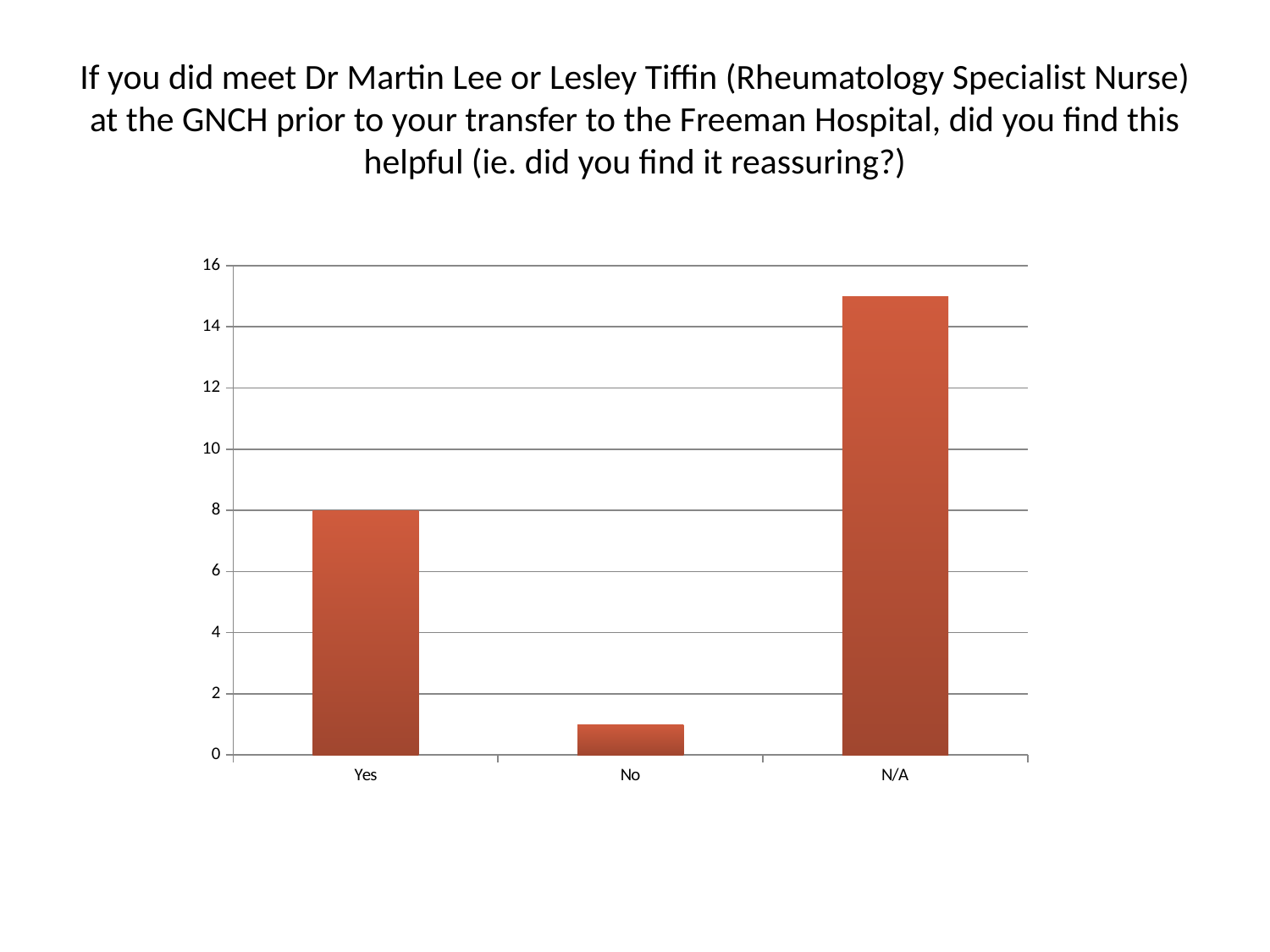
Is the value for Yes greater or less than 10? less What is the highest value shown on the y axis of the chart? 16 Which is larger, the value for Yes or the value for No? Yes Is the value for No greater or less than 2? less What is the value for the Yes category? 8 What are the three category labels on the x axis, from left to right? Yes, No, N/A Which category has the lowest value? No Which is larger, the value for Yes or the value for N/A? N/A Which category has the highest value? N/A How many categories are shown on the x axis of the chart? 3 What kind of chart is shown on the slide? bar chart Is the value for N/A greater or less than 14? greater